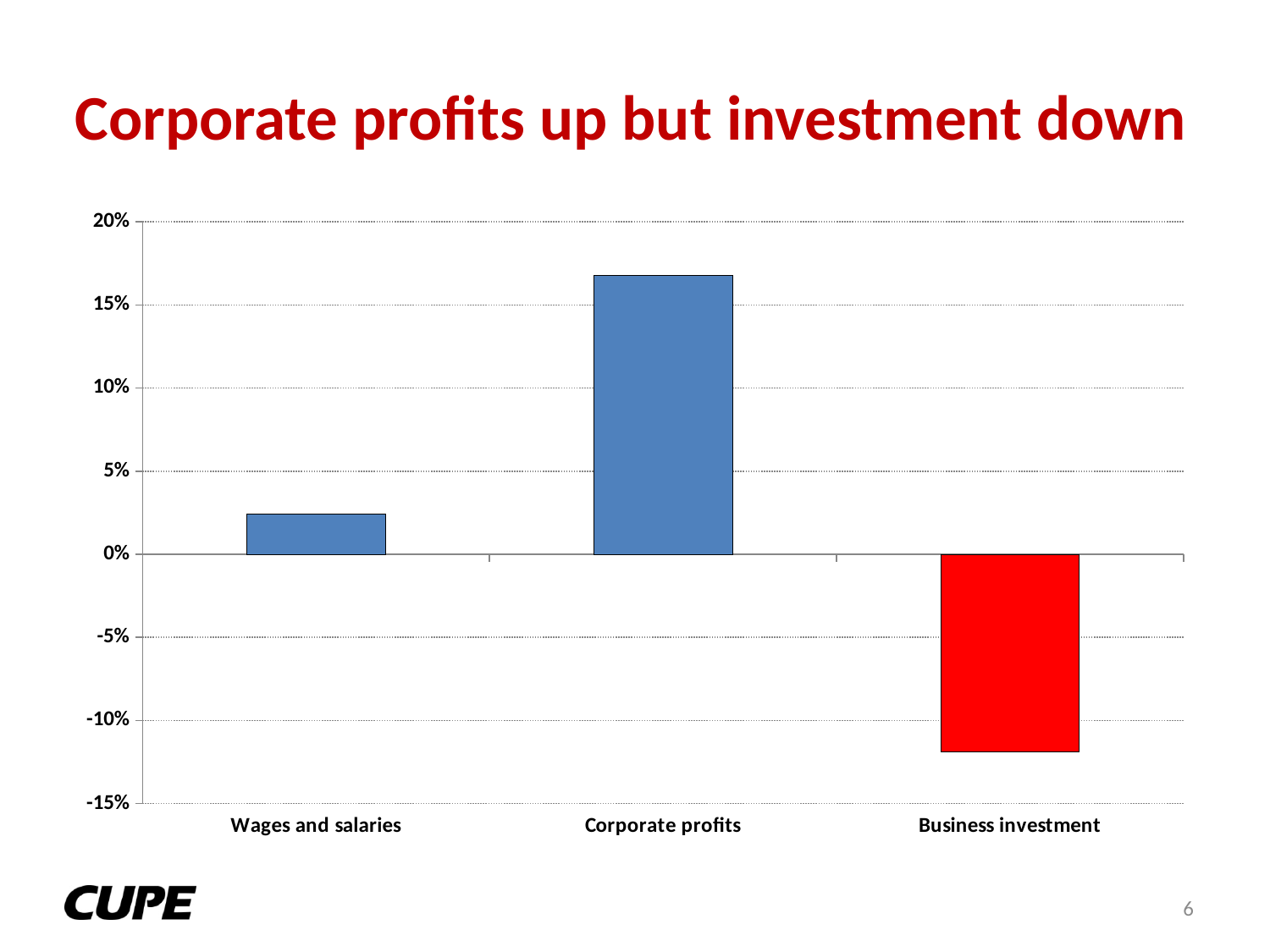
Which category's bar is coloured red in the chart? Business investment Which category has the lowest value in the chart? Business investment Is the value for Business investment greater or less than 0%? less What is the title of the slide containing the chart? Corporate profits up but investment down Is the value for Business investment greater or less than -10%? less Is the value for Wages and salaries greater or less than 5%? less Which category has the highest value in the chart? Corporate profits How many categories are shown on the x axis of the chart? 3 Which is larger, the value for Wages and salaries or the value for Corporate profits? Corporate profits What kind of chart is shown on the slide? bar chart